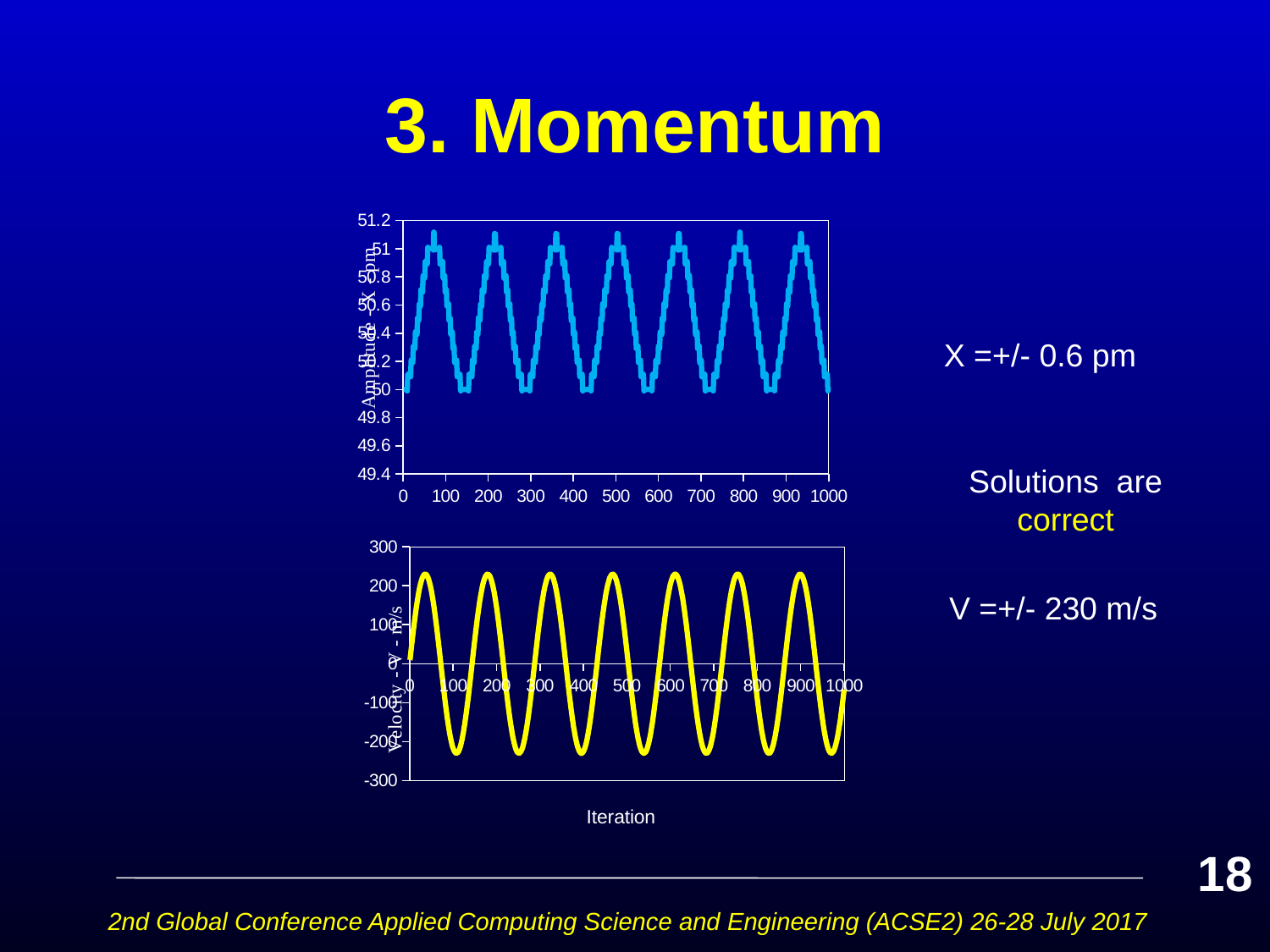
On the bottom chart (Velocity - m/s), what are the lowest and highest values shown on the y axis? -300 and 300 What kind of chart is the bottom chart (Velocity - m/s)? line chart On the bottom chart (Velocity - m/s), is the peak velocity greater or less than 100? greater What kind of chart is the top chart (Amplitude X - pm)? line chart On the bottom chart (Velocity - m/s), is the lowest value of the curve greater or less than -100? less On the bottom chart (Velocity - m/s), does the velocity rise steadily, fall steadily, or oscillate as the iteration increases? oscillate On the top chart (Amplitude X - pm), what is the largest value shown on the x axis? 1000 On the top chart (Amplitude X - pm), is the highest value of the curve greater or less than 51.2? less On the top chart (Amplitude X - pm), how many peaks does the curve have between iteration 0 and 1000? 7 On the top chart (Amplitude X - pm), does the amplitude rise steadily, fall steadily, or oscillate as the iteration increases? oscillate